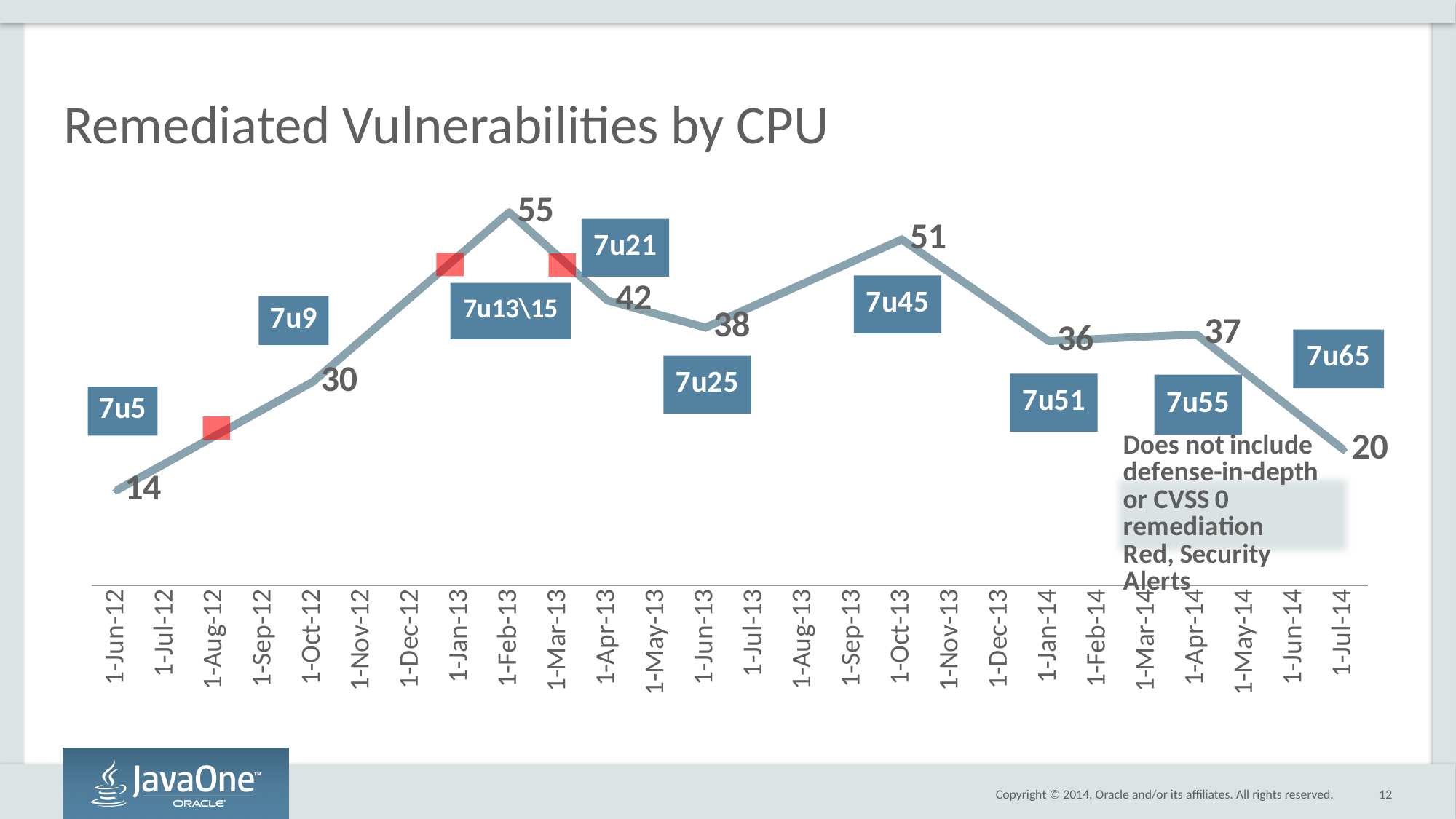
What is the value plotted for 1-Jul-14? 20 Which date has the highest labelled value? 1-Feb-13 What type of chart is shown on the slide? line chart Does the line rise or fall between 1-Apr-14 and 1-Jul-14? fall How many data points on the line have a printed value label? 9 Which is larger, the value for 1-Oct-13 or the value for 1-Jan-14? 1-Oct-13 Which date has the lowest labelled value? 1-Jun-12 What is the difference between the values for 1-Feb-13 and 1-Apr-13? 13 What is the value plotted for 1-Jun-12? 14 What is the value plotted for 1-Feb-13? 55 What is the title of the chart? Remediated Vulnerabilities by CPU What is the value plotted for 1-Oct-13? 51